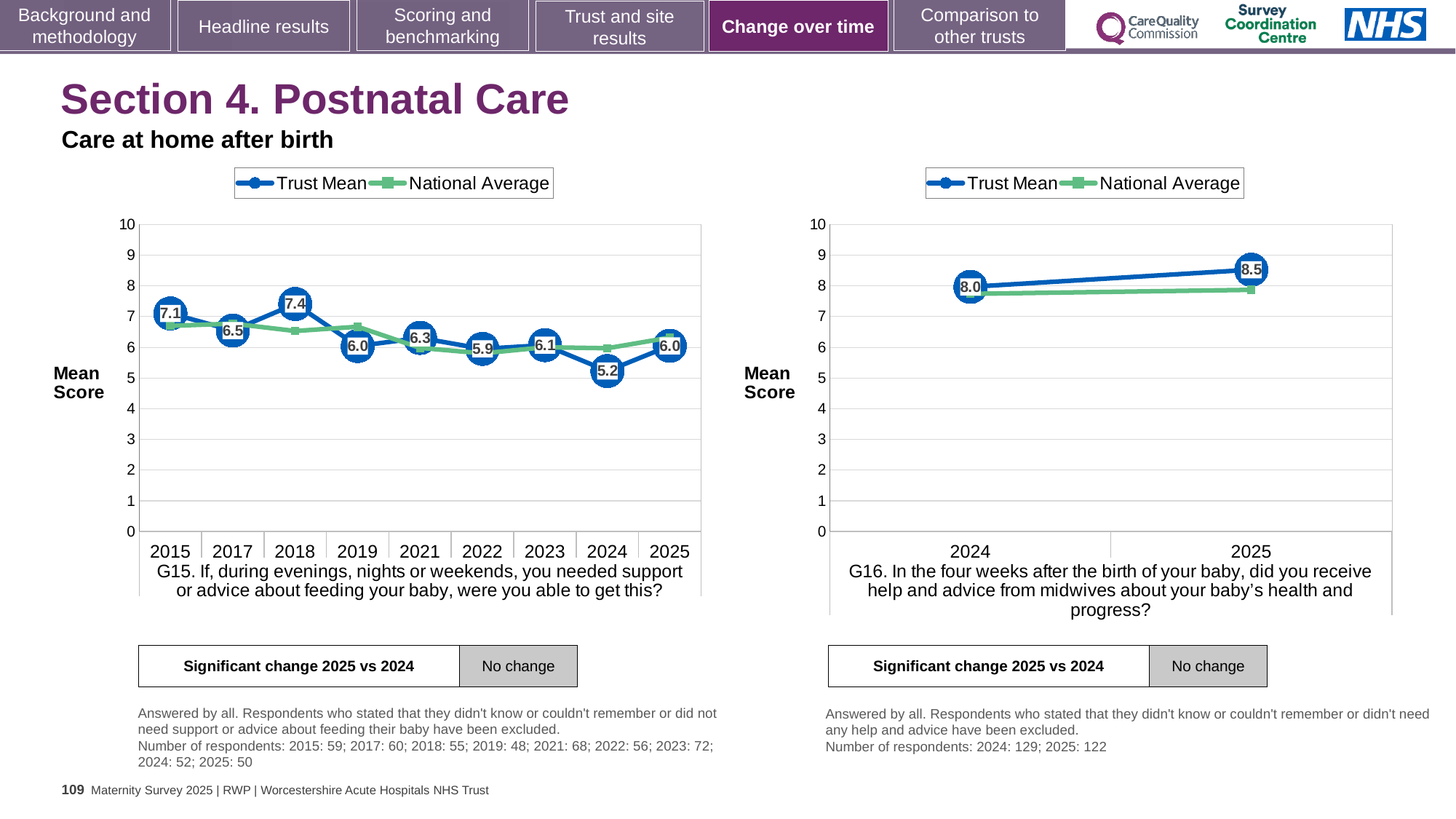
In the left chart (G15), what is the Trust Mean score for 2018? 7.4 In the left chart (G15), how many series does the legend list? 2 In the right chart (G16), for 2025, which is higher: the Trust Mean or the National Average? Trust Mean In the right chart (G16), does the Trust Mean rise or fall from 2024 to 2025? Rises In the right chart (G16), what is the difference between the Trust Mean scores for 2025 and 2024? 0.5 What type of chart is the right chart (G16)? Line chart In the left chart (G15), what is the Trust Mean score for 2024? 5.2 In the left chart (G15), how many years are plotted on the x axis? 9 In the right chart (G16), what is the Trust Mean score for 2025? 8.5 In the left chart (G15), which year has the highest Trust Mean score? 2018 In the left chart (G15), by how much did the Trust Mean score change from 2024 to 2025? 0.8 In the left chart (G15), which year has the lowest Trust Mean score? 2024